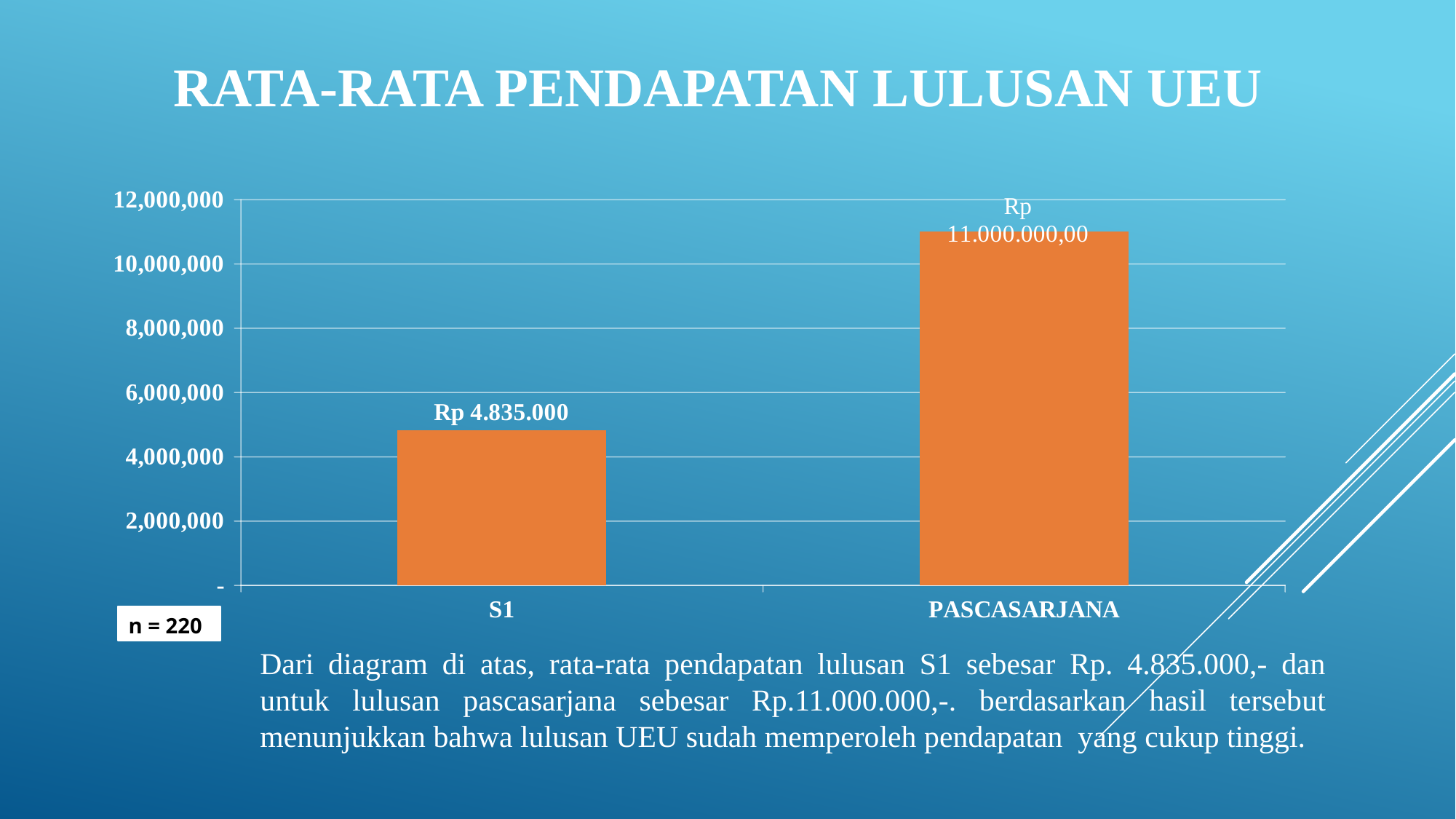
What is the value shown for S1? Rp 4.835.000 How many categories are shown on the chart? 2 Is the value for PASCASARJANA greater or less than 10,000,000? greater Which category has the lowest value? S1 What is the difference between the value for PASCASARJANA and the value for S1? Rp 6.165.000 Which category has the highest value? PASCASARJANA What kind of chart is shown on the slide? bar chart What sample size (n) is shown next to the chart? n = 220 Is the value for S1 greater or less than 6,000,000? less Which is larger, the value for S1 or the value for PASCASARJANA? PASCASARJANA What is the value shown for PASCASARJANA? Rp 11.000.000,00 What is the title of the slide containing the chart? RATA-RATA PENDAPATAN LULUSAN UEU